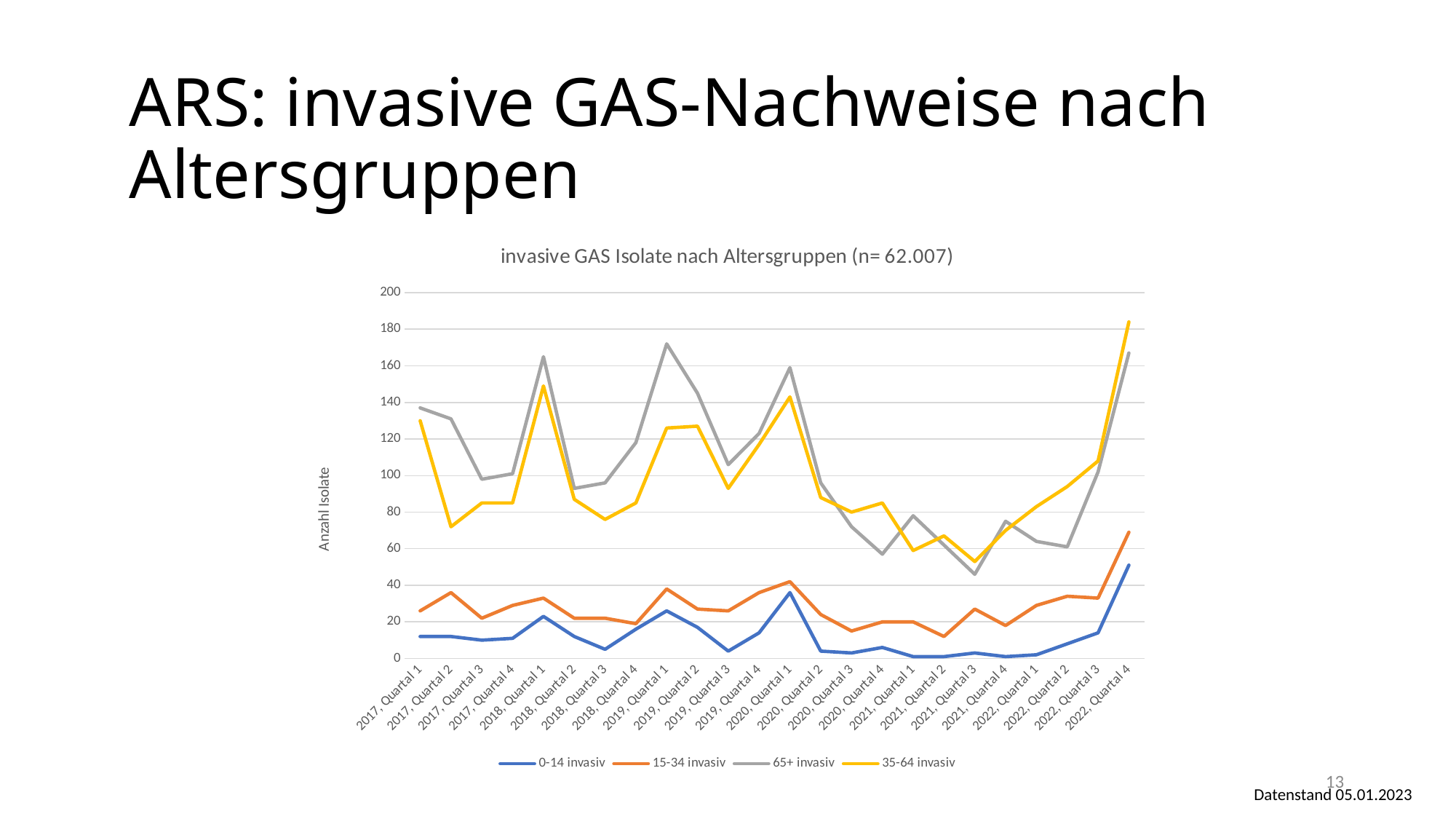
In which quarter does the 65+ invasiv series reach its lowest value? 2021, Quartal 3 Which series is drawn in yellow? 35-64 invasiv Does the 0-14 invasiv series rise or fall from 2022, Quartal 1 to 2022, Quartal 4? rise How many quarters are plotted along the x axis? 24 What is the title of the chart? invasive GAS Isolate nach Altersgruppen (n= 62.007) How many series does the legend list? 4 What kind of chart is shown on the slide? line chart In which quarter does the 35-64 invasiv series reach its highest value? 2022, Quartal 4 Is the value for 65+ invasiv in 2021, Quartal 3 greater or less than 60? less Is the value for 0-14 invasiv in 2022, Quartal 4 greater or less than 40? greater In 2019, Quartal 1, which is larger: 65+ invasiv or 35-64 invasiv? 65+ invasiv Is the value for 35-64 invasiv in 2022, Quartal 4 greater or less than 160? greater